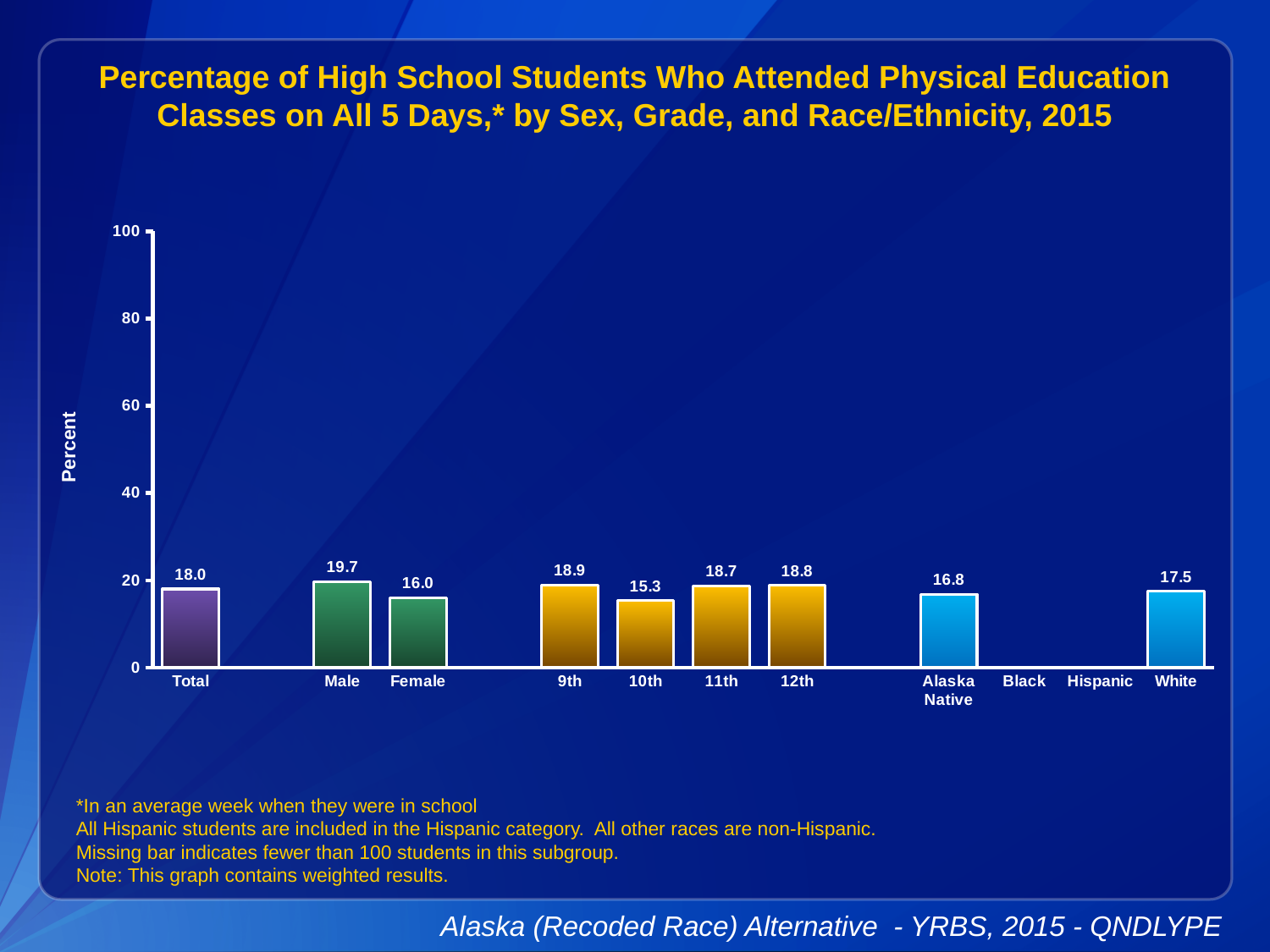
Which category has the highest value? Male What is the difference between the Male and Female values? 3.7 What is the value for 10th grade? 15.3 What is the label on the y axis? Percent Which is larger, the value for 9th grade or the value for 10th grade? 9th What is the value for Female? 16.0 What is the value for Total? 18.0 Is the value for White greater or less than 20? less Which category with a bar has the lowest value? 10th How many categories on the x axis have no bar shown? 2 What is the value for Alaska Native? 16.8 What kind of chart is shown? bar chart